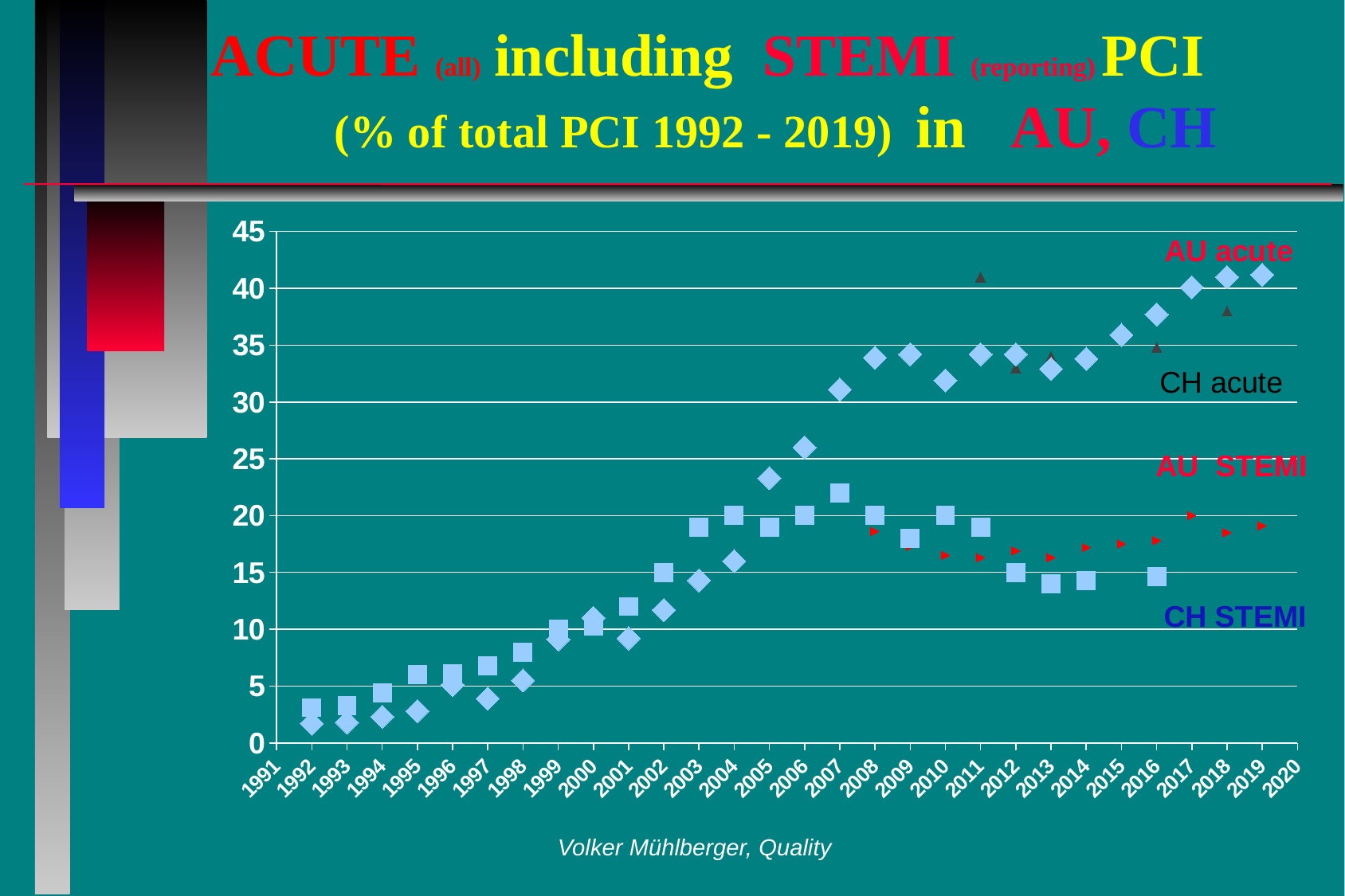
Is the value for AU acute in 2005 greater or less than 20? greater Does the CH STEMI series rise or fall from 2007 to 2013? fall What is the highest value shown on the y axis? 45 Is the value for AU acute in 2017 greater or less than 35? greater Is the value for CH STEMI in 2003 greater or less than 15? greater What kind of chart is shown on the slide? scatter chart How many data series are labelled on the chart? 4 Which series are labelled on the chart? AU acute, CH acute, AU STEMI, CH STEMI Does the AU acute series rise or fall from 1992 to 2019? rise